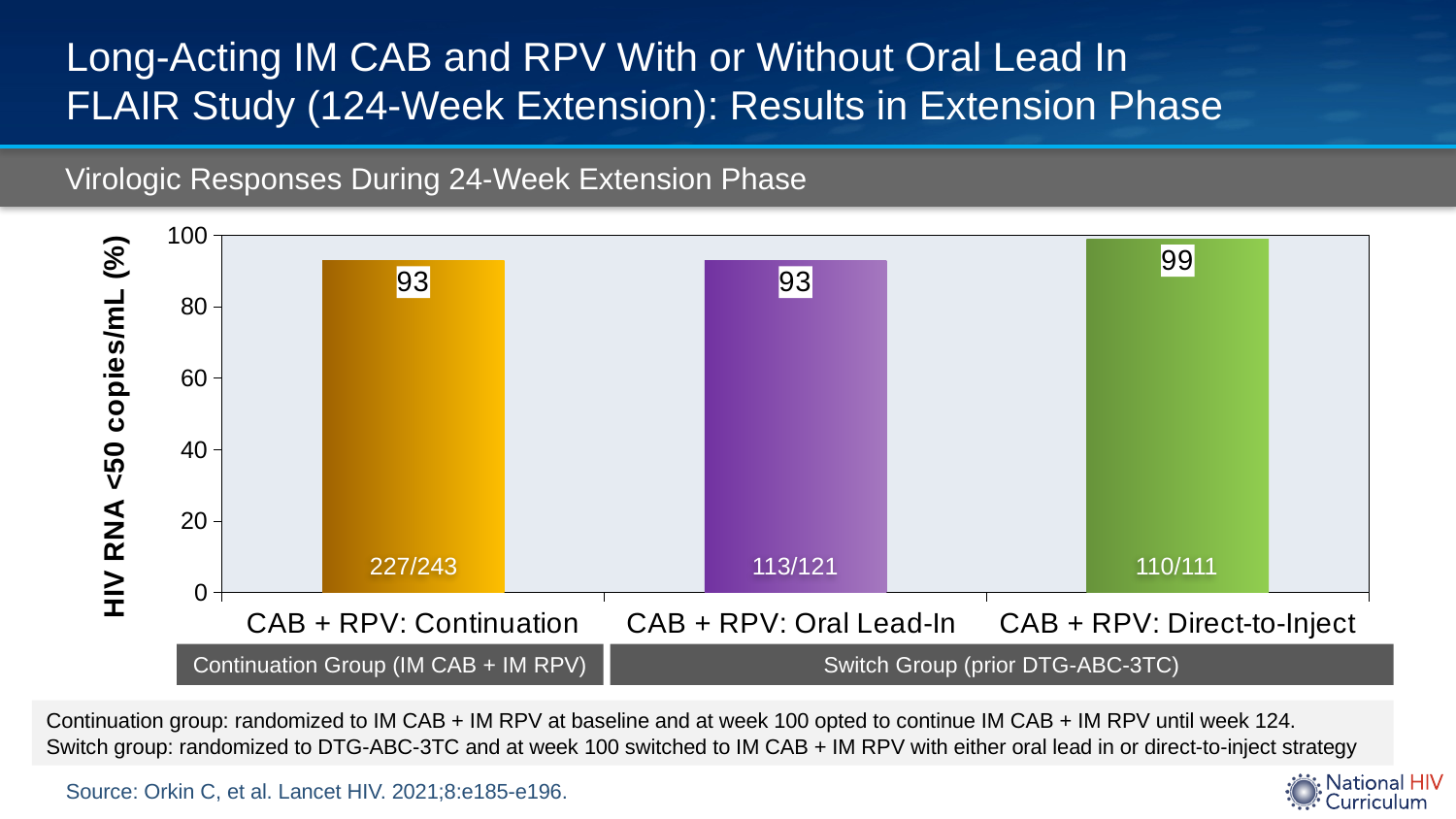
Which is larger, the value for CAB + RPV: Direct-to-Inject or CAB + RPV: Continuation? CAB + RPV: Direct-to-Inject How many categories are shown on the x axis? 3 What kind of chart is shown on the slide? bar chart What fraction is printed inside the bar for CAB + RPV: Direct-to-Inject? 110/111 What is the value for CAB + RPV: Continuation? 93 What is the label of the y axis? HIV RNA <50 copies/mL (%) Is the value for CAB + RPV: Oral Lead-In greater or less than 80? greater What is the difference between the values for CAB + RPV: Direct-to-Inject and CAB + RPV: Oral Lead-In? 6 What is the value for CAB + RPV: Direct-to-Inject? 99 What fraction is printed inside the bar for CAB + RPV: Continuation? 227/243 Which category has the highest value? CAB + RPV: Direct-to-Inject What is the value for CAB + RPV: Oral Lead-In? 93